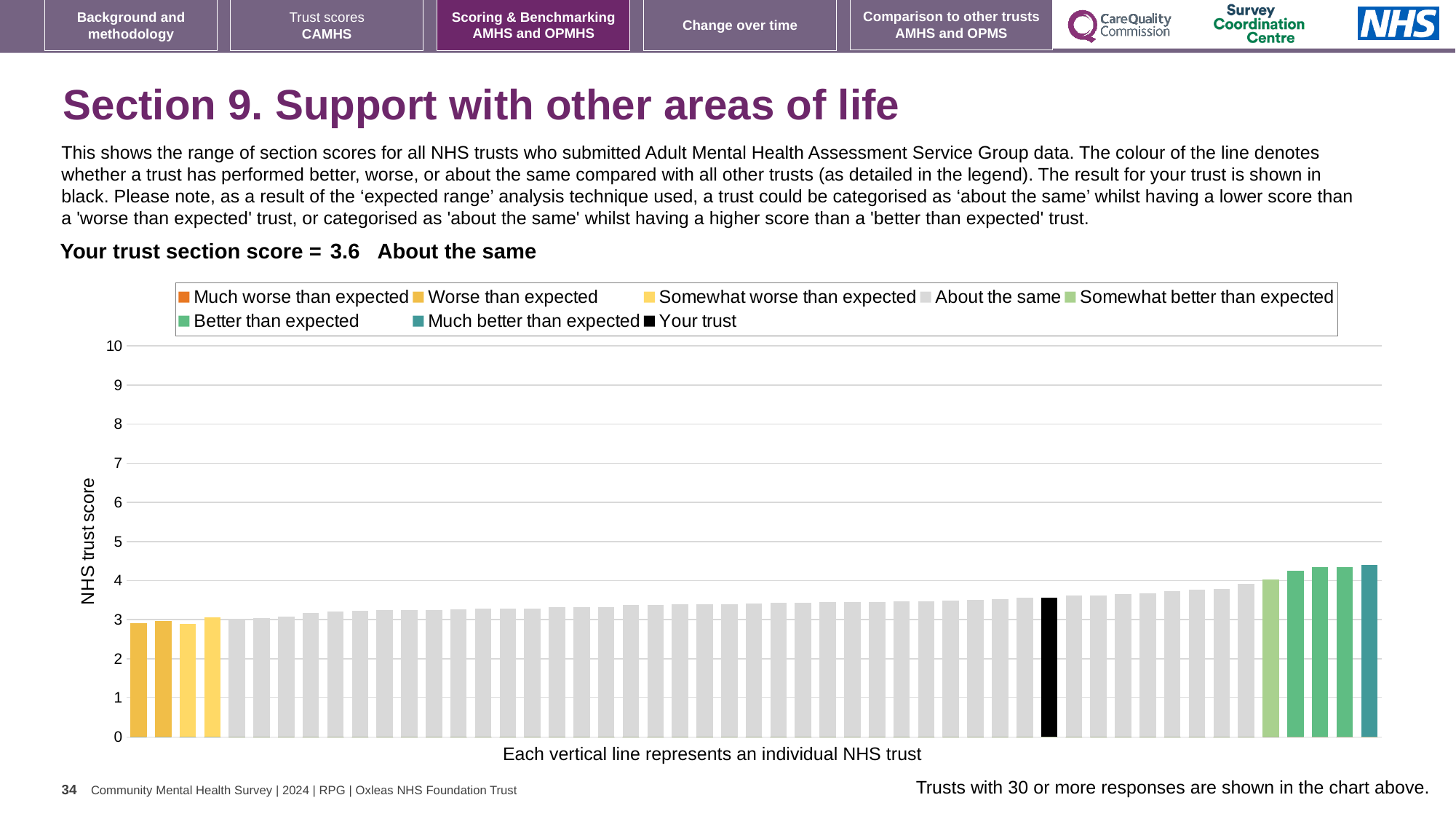
Do the bar values rise or fall from left to right along the x axis? rise Is the value for Your trust greater or less than 4? less Is the value for Your trust greater or less than 3? greater Is the highest bar in the chart greater or less than 4? greater What colour is the bar for Your trust? black How many bars are coloured as 'Much better than expected'? 1 What is the section score for Your trust? 3.6 What kind of chart is shown on the slide? bar chart Which legend category does Your trust fall into? About the same What is the label on the vertical axis? NHS trust score How many entries does the chart legend list? 8